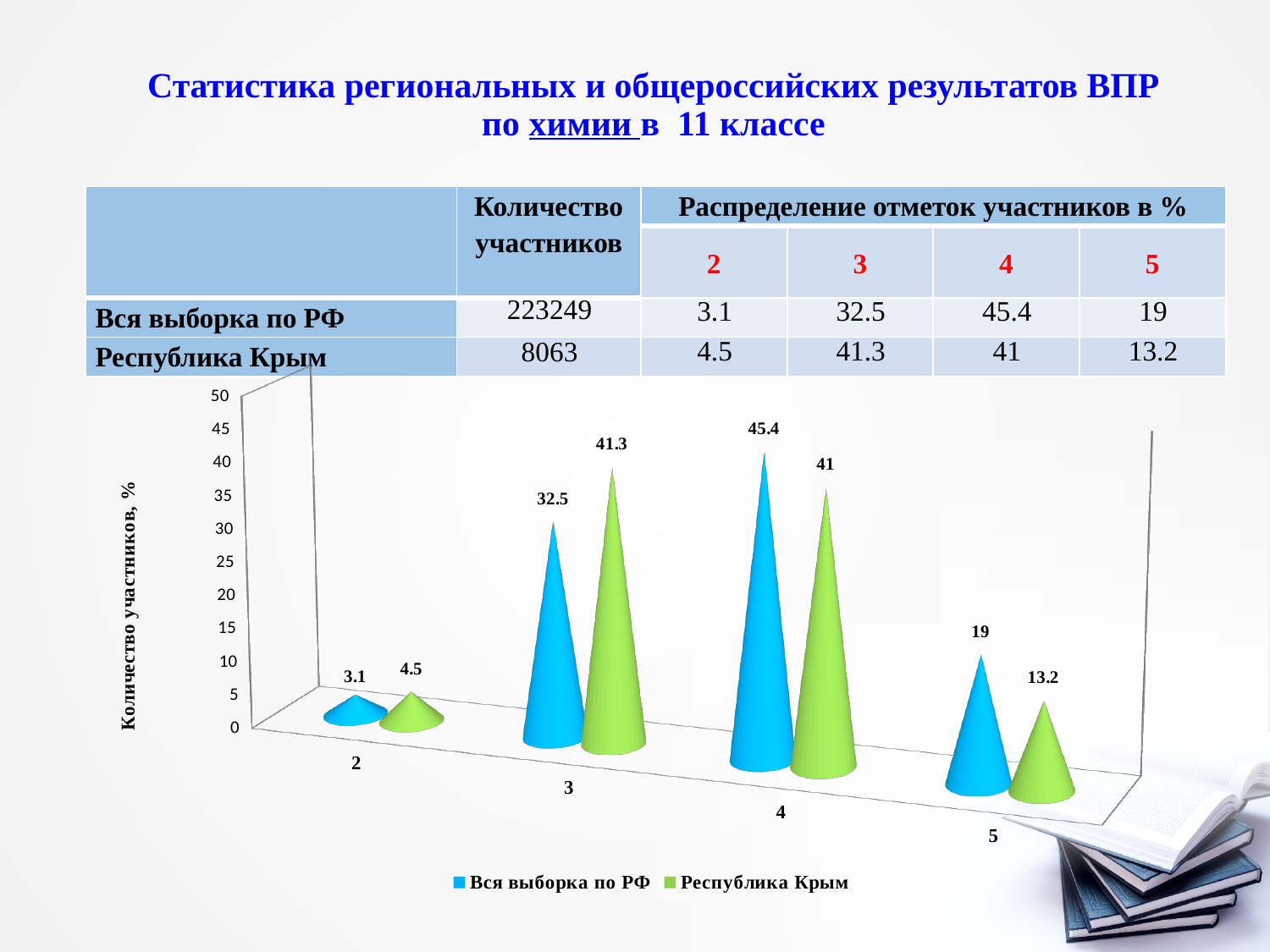
Which grade category has the lowest value for the series "Республика Крым"? 2 What kind of chart is shown on the slide? bar chart What is the label of the vertical axis of the chart? Количество участников, % What is the value for grade 3 in the series "Республика Крым"? 41.3 What is the value for grade 4 in the series "Вся выборка по РФ"? 45.4 Which grade category has the highest value for the series "Вся выборка по РФ"? 4 How many series does the chart legend list? 2 What is the difference between the "Вся выборка по РФ" and "Республика Крым" values for grade 5? 5.8 For grade 3, which series has the larger value: "Вся выборка по РФ" or "Республика Крым"? Республика Крым What is the value for grade 5 in the series "Республика Крым"? 13.2 How many grade categories are shown on the x axis of the chart? 4 Is the value for grade 4 in the series "Республика Крым" greater or less than 35? greater